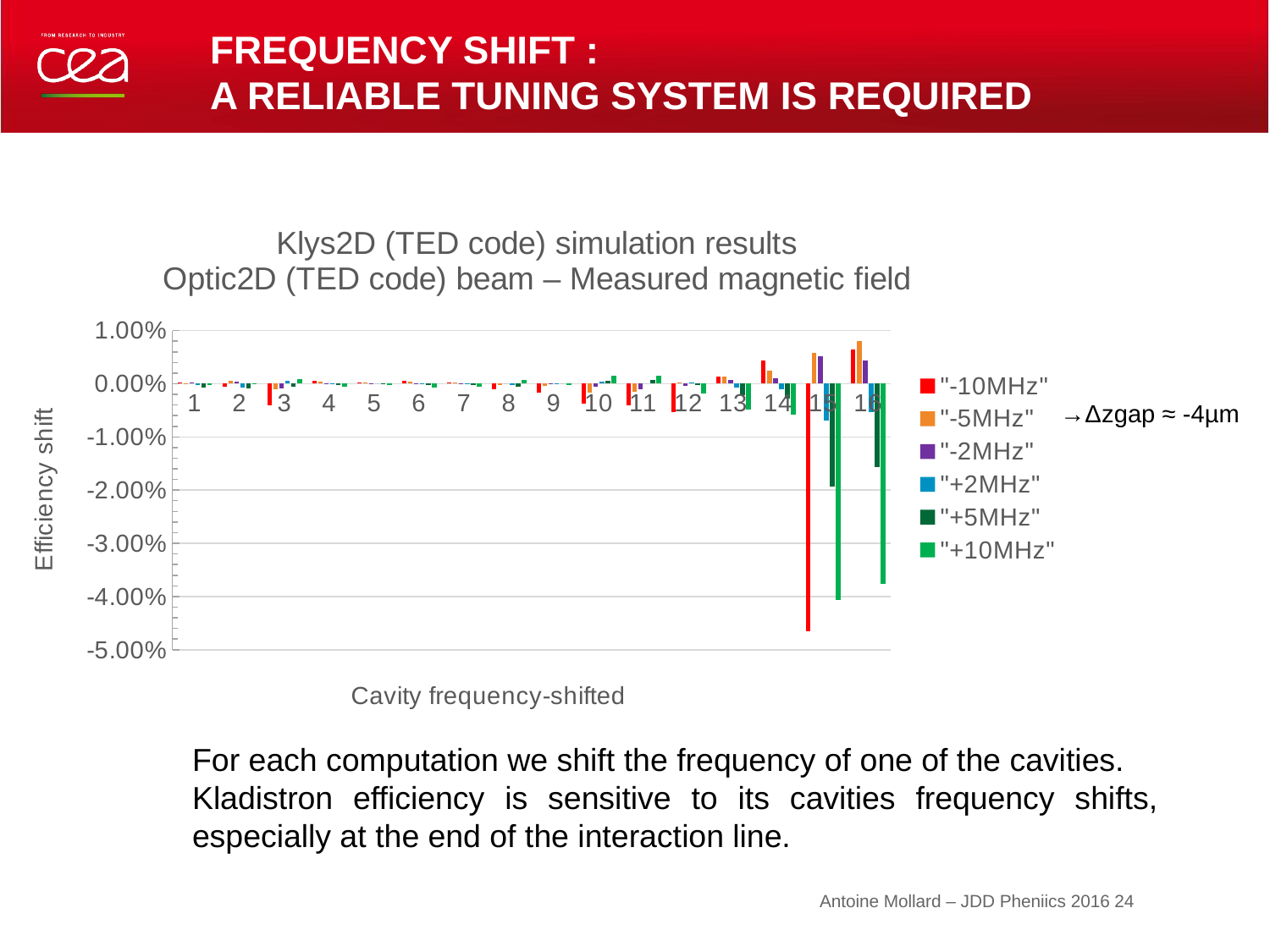
How many series does the chart's legend list? 6 How many cavity categories are shown along the x axis of the chart? 16 Which series in the chart has the lowest value overall? "-10MHz" What is the title of the x axis of the chart? Cavity frequency-shifted Is the efficiency shift for the "-5MHz" series at cavity 16 greater or less than 0.00%? greater Which is lower: the "-10MHz" value at cavity 15 or the "+10MHz" value at cavity 16? "-10MHz" at cavity 15 What is the title of the y axis of the chart? Efficiency shift Is the efficiency shift for the "+5MHz" series at cavity 16 greater or less than -1.00%? less Is the efficiency shift for the "-10MHz" series at cavity 15 greater or less than -4.00%? less Which cavity has the lowest efficiency shift for the "-10MHz" series? 15 What kind of chart is shown on the slide? bar chart